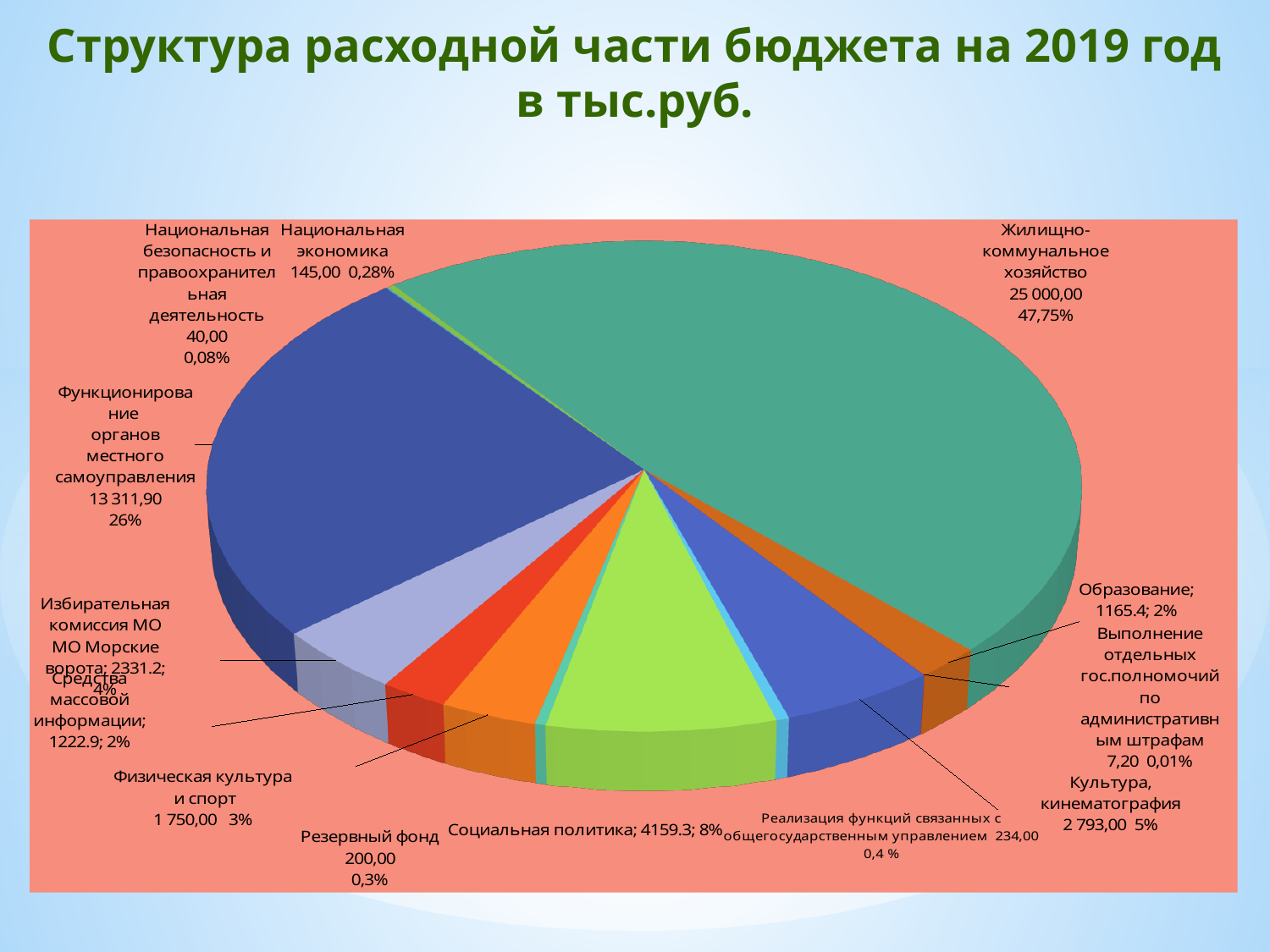
What is the value for Жилищно-коммунальное хозяйство? 25 000,00 What is the value for Культура, кинематография? 2 793,00 Which category has the smallest slice of the pie? Выполнение отдельных гос.полномочий по административным штрафам How many categories are shown in the pie chart? 13 What is the value for Национальная экономика? 145,00 What is the title of the chart on the slide? Структура расходной части бюджета на 2019 год в тыс.руб. Which category has the largest slice of the pie? Жилищно-коммунальное хозяйство What share of the pie does Жилищно-коммунальное хозяйство take? 47,75% Which is larger, Физическая культура и спорт or Резервный фонд? Физическая культура и спорт What is the value for Функционирование органов местного самоуправления? 13 311,90 What share of the pie does Социальная политика take? 8% What kind of chart is shown on the slide? pie chart